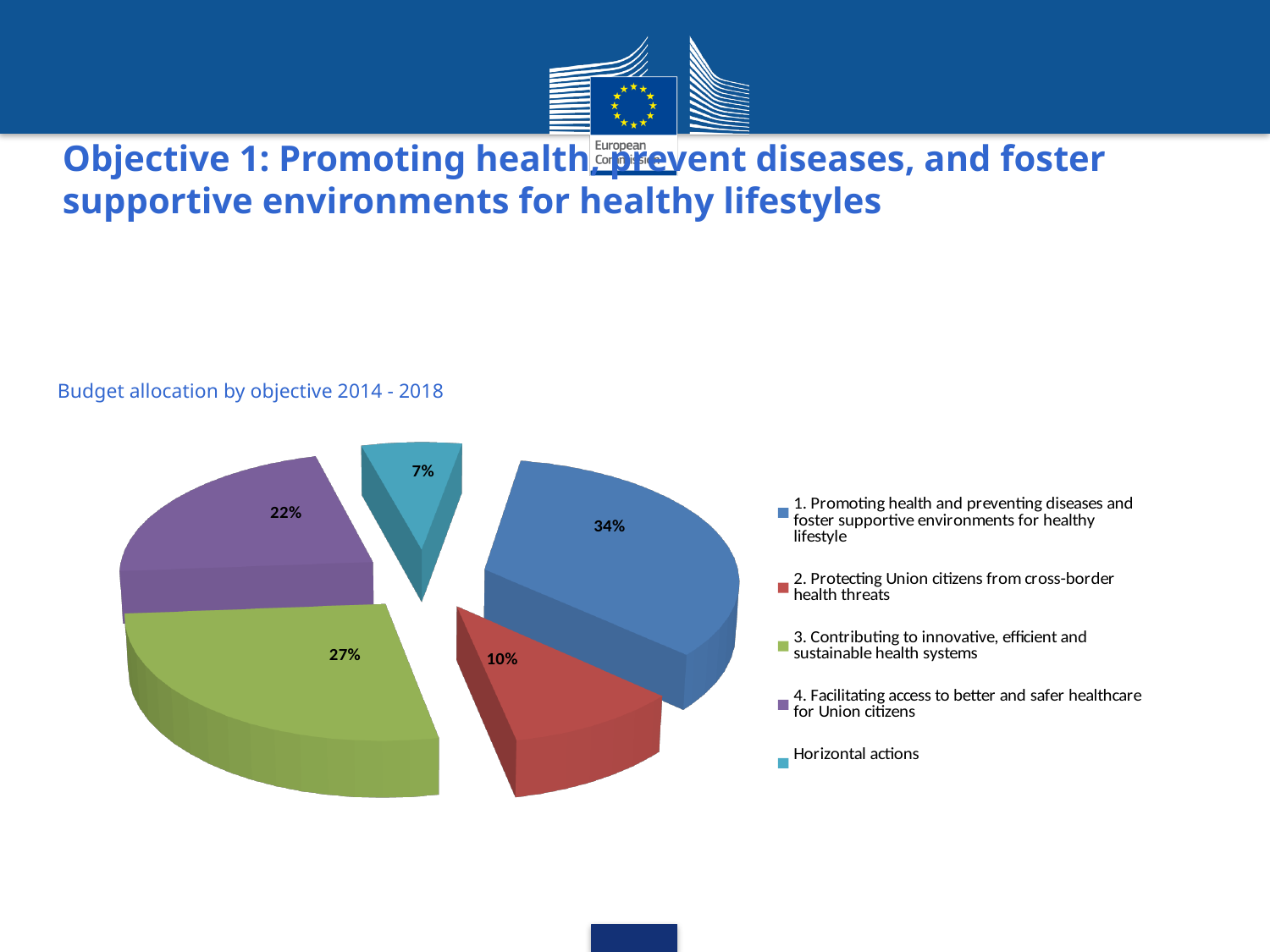
Which receives a larger share: objective 4, facilitating access to better and safer healthcare, or objective 2, protecting Union citizens from cross-border health threats? 4. Facilitating access to better and safer healthcare for Union citizens What share of the budget goes to objective 2, protecting Union citizens from cross-border health threats? 10% What is the difference in percentage points between objective 1 (34%) and objective 3 (27%)? 7 What type of chart is shown on the slide? Pie chart What share of the budget is allocated to objective 3, contributing to innovative, efficient and sustainable health systems? 27% Which objective receives the largest share of the budget? 1. Promoting health and preventing diseases and foster supportive environments for healthy lifestyle What share of the budget is allocated to Horizontal actions? 7% How many slices does the pie chart have? 5 What colour is the slice for objective 3, contributing to innovative, efficient and sustainable health systems? Green What is the title of the chart? Budget allocation by objective 2014 - 2018 Which category receives the smallest share of the budget? Horizontal actions What share of the budget is allocated to objective 1, promoting health and preventing diseases? 34%